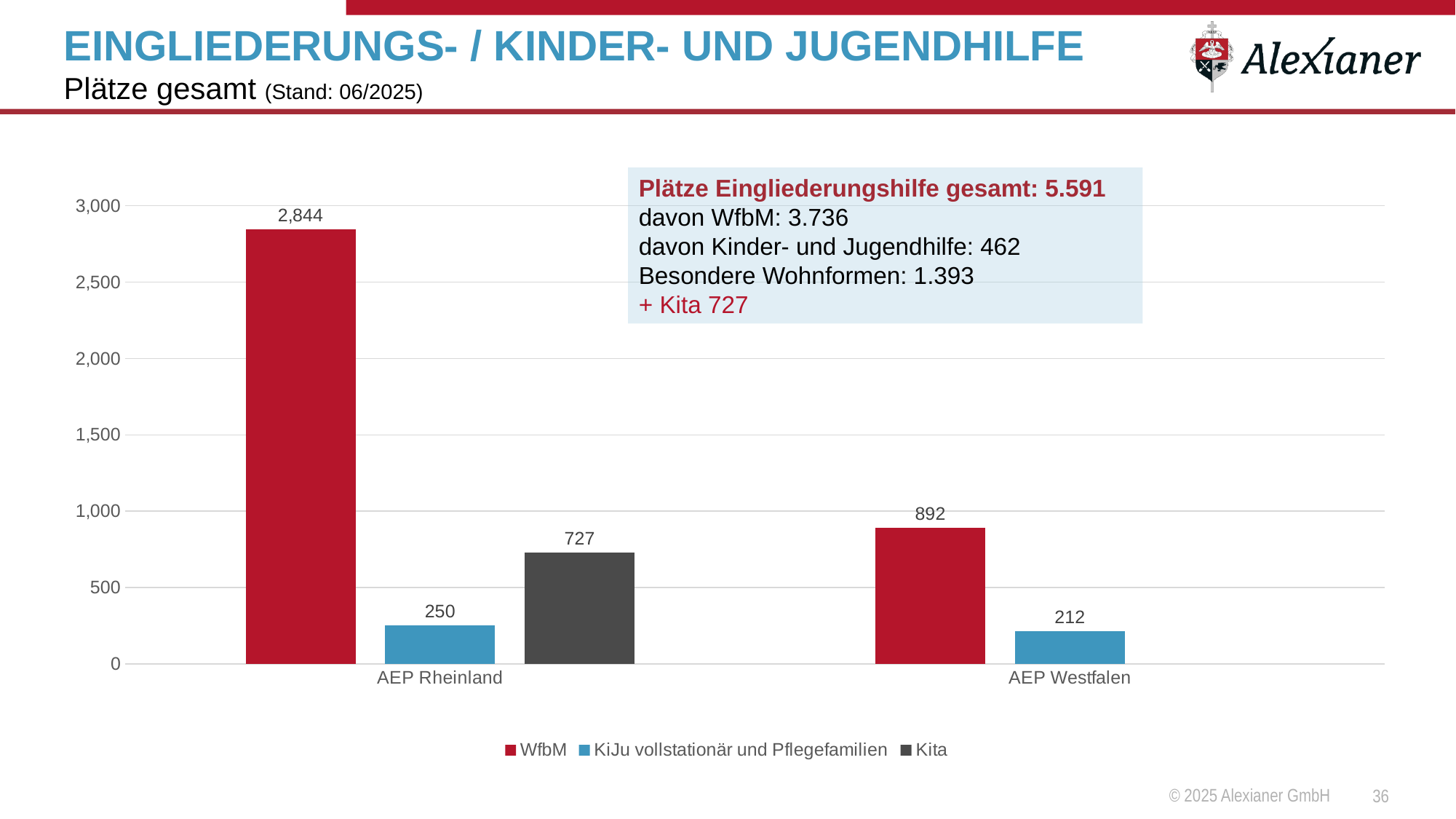
What is the Kita value for AEP Rheinland? 727 What is the WfbM value for AEP Rheinland? 2,844 What is the value for KiJu vollstationär und Pflegefamilien at AEP Westfalen? 212 Which is larger: the KiJu vollstationär und Pflegefamilien value for AEP Rheinland or for AEP Westfalen? AEP Rheinland What kind of chart is shown on the slide? bar chart Which category has the highest WfbM value? AEP Rheinland Which series has the lowest value at AEP Westfalen? KiJu vollstationär und Pflegefamilien Is the WfbM value for AEP Westfalen greater or less than 1,000? less What is the difference between the WfbM values for AEP Rheinland and AEP Westfalen? 1,952 How many series does the legend list? 3 How many categories are shown on the x axis? 2 What is the WfbM value for AEP Westfalen? 892